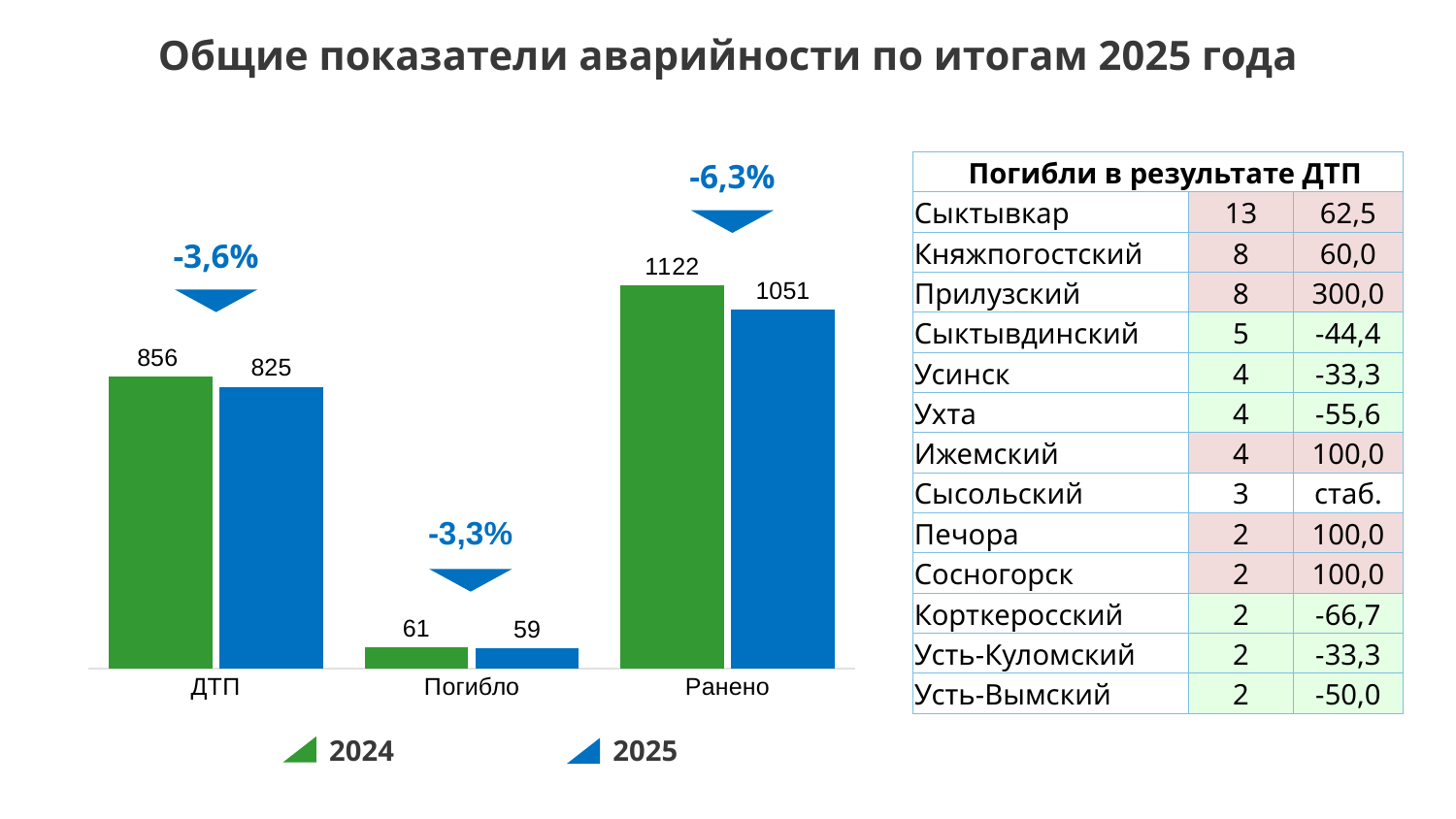
What percentage change is shown above the Ранено bars? -6,3% Which category has the highest value in 2025? Ранено Which category has the lowest value in 2024? Погибло What kind of chart is shown on the slide? bar chart What is the value for Ранено in 2025? 1051 What is the value for ДТП in 2024? 856 How many series does the legend list? 2 What is the difference between the 2024 and 2025 values for ДТП? 31 What is the value for Погибло in 2024? 61 How many categories are shown on the x axis of the chart? 3 Which is larger, the 2024 value for ДТП or the 2025 value for ДТП? 2024 What is the difference between the 2024 and 2025 values for Ранено? 71